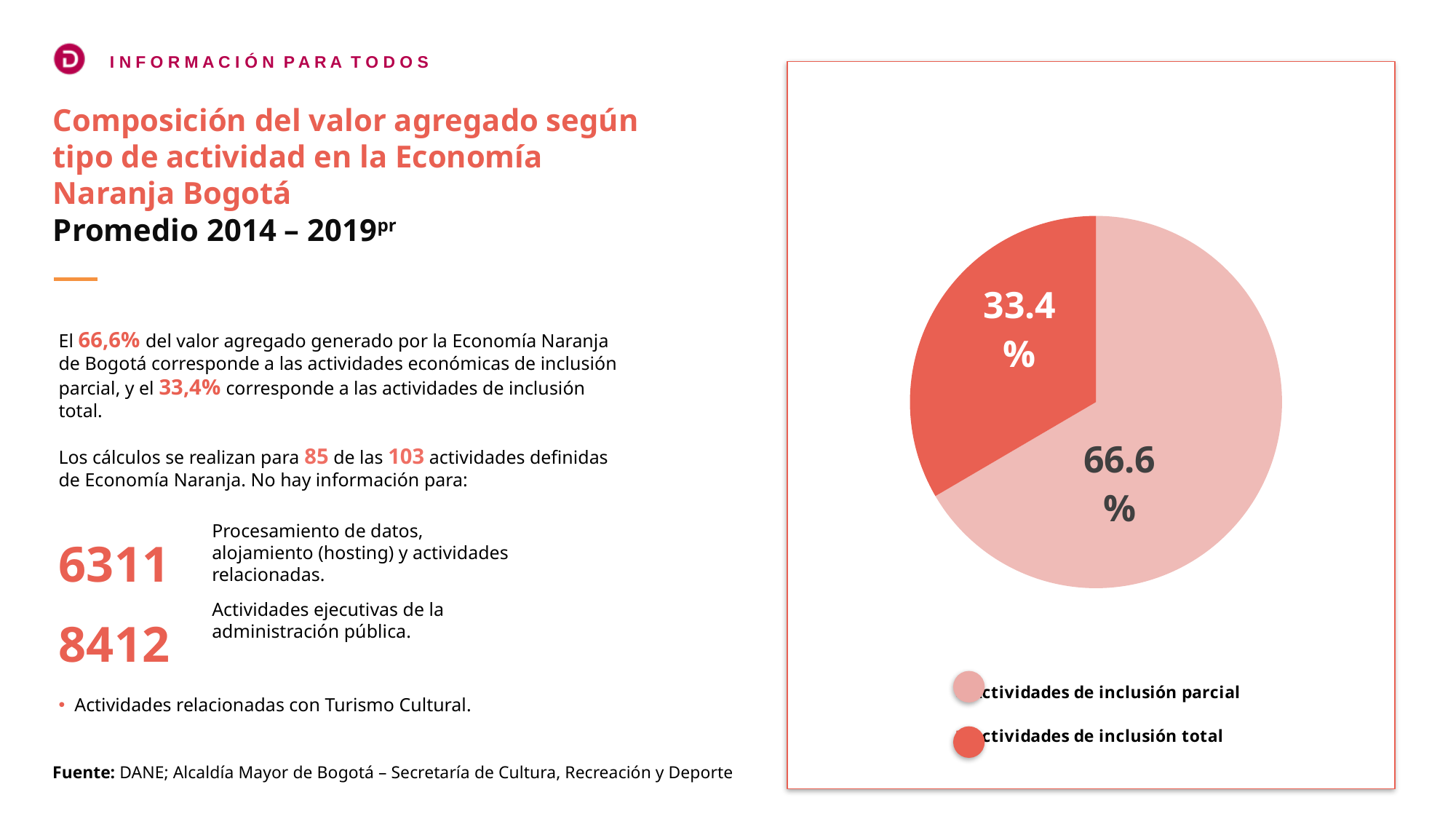
Which legend entry is shown in the darker red colour? Actividades de inclusión total What is the difference in percentage points between the slice for Actividades de inclusión parcial and the slice for Actividades de inclusión total? 33.2 Which category has the smallest slice of the pie? Actividades de inclusión total How many entries does the legend of the pie chart list? 2 What share of the pie corresponds to Actividades de inclusión total? 33.4% Is the share for Actividades de inclusión total greater or less than 50%? less Which category has the largest slice of the pie? Actividades de inclusión parcial How many slices does the pie chart have? 2 Which legend entry is shown in the light pink colour? Actividades de inclusión parcial What kind of chart is shown on the slide? pie chart What share of the pie corresponds to Actividades de inclusión parcial? 66.6% Which is larger: the slice for Actividades de inclusión parcial or the slice for Actividades de inclusión total? Actividades de inclusión parcial